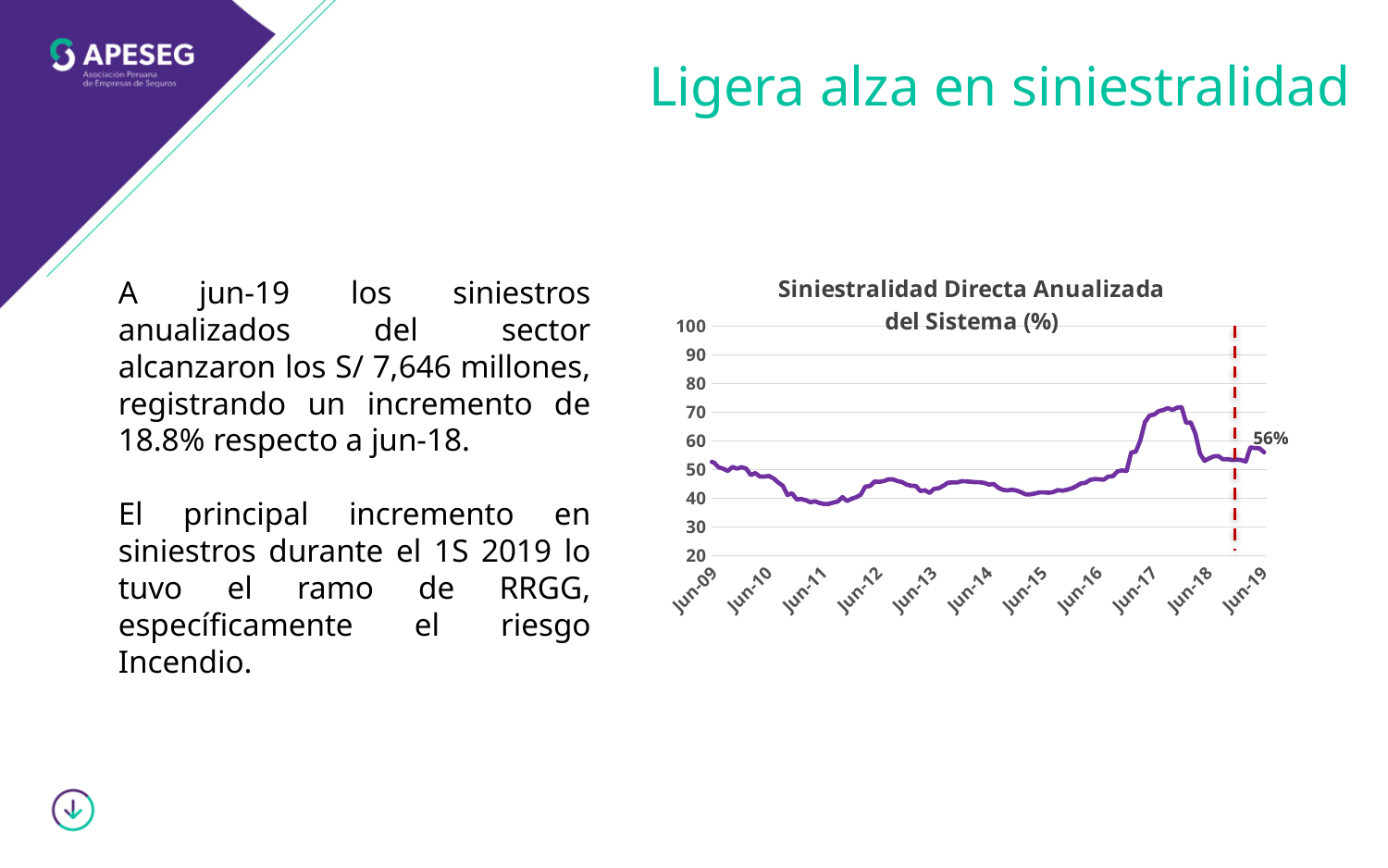
What kind of chart is shown on the slide? line chart Which of the labelled dates, Jun-17 or Jun-19, has the higher value? Jun-17 What is the highest value shown on the y axis of the chart? 100 Among the labelled dates on the x axis, which one has the highest value? Jun-17 Is the value for Jun-11 greater or less than 50? less Does the line rise or fall between Jun-17 and Jun-18? fall What is the title of the chart? Siniestralidad Directa Anualizada del Sistema (%) Is the value for Jun-15 greater or less than 50? less How many date labels are shown on the x axis of the chart? 11 Is the value for Jun-17 greater or less than 60? greater What colour is the plotted line in the chart? purple What value is labelled on the chart for Jun-19? 56%